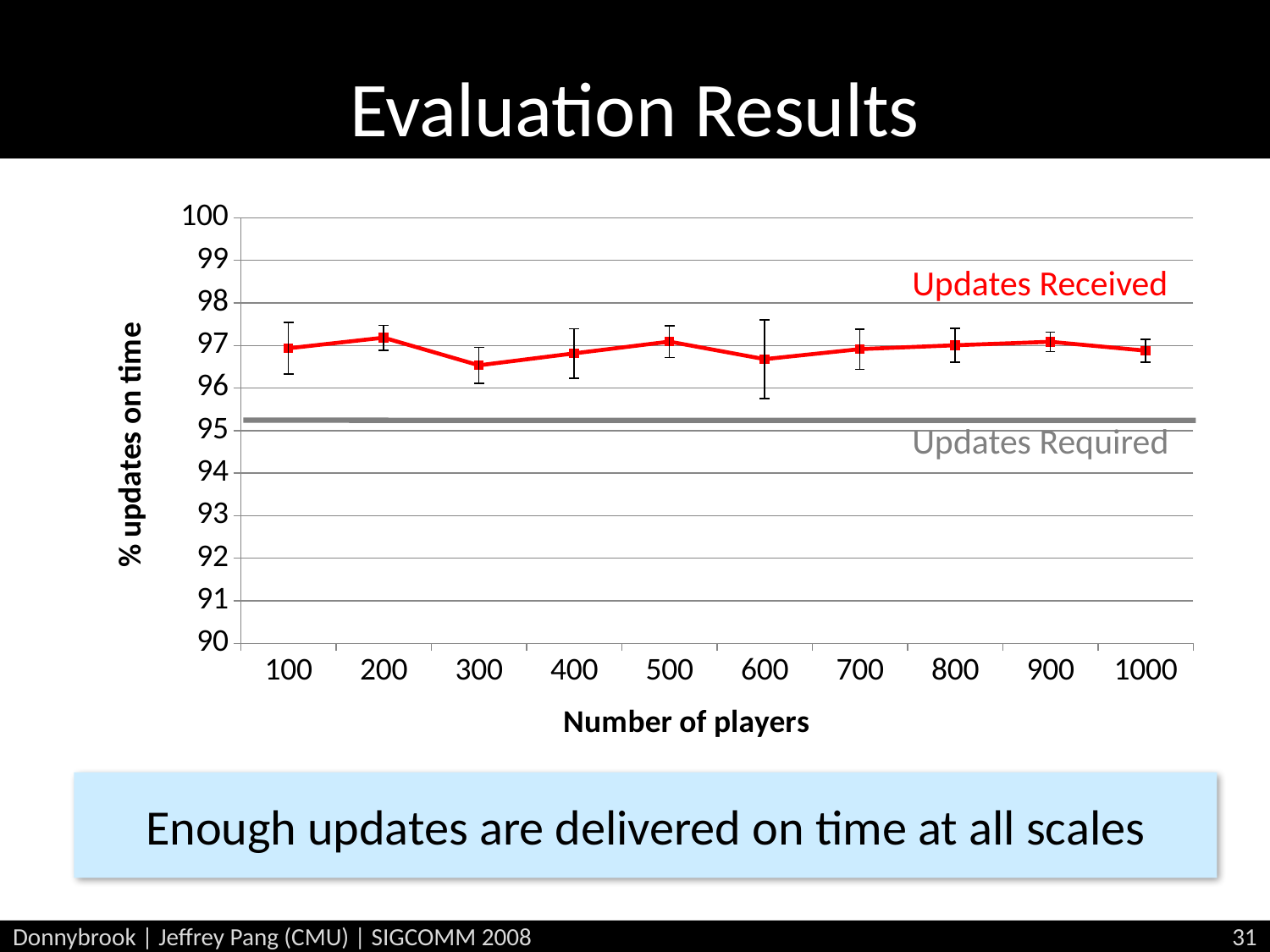
What kind of chart is shown on the slide? line chart What is the label of the y axis? % updates on time How many data points are plotted along the x axis for Updates Received? 10 Which is larger, the Updates Received value at 200 players or at 300 players? 200 players At 500 players, which series has the larger value, Updates Received or Updates Required? Updates Received What is the label of the x axis? Number of players What is the lowest value shown on the y axis? 90 Is the Updates Received value at 600 players greater or less than 97? less Is the Updates Received value at 100 players greater or less than 96? greater Is the Updates Required line greater or less than 96? less